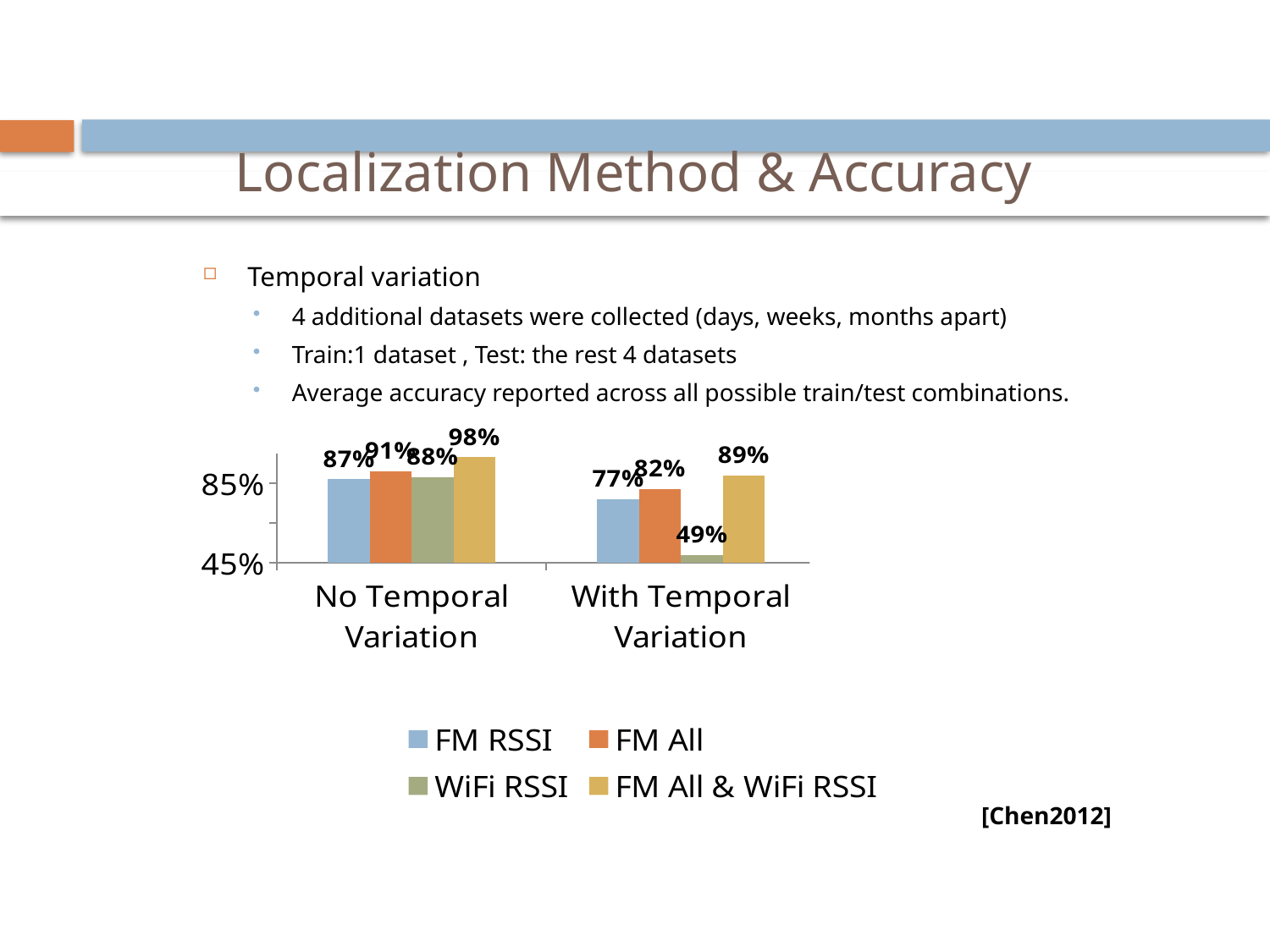
Is the WiFi RSSI value under With Temporal Variation greater or less than 85%? less Which series has the highest accuracy under No Temporal Variation? FM All & WiFi RSSI How many categories are shown on the x axis of the chart? 2 What is the accuracy for FM All & WiFi RSSI under No Temporal Variation? 98% What kind of chart is shown on the slide? bar chart What is the accuracy for FM RSSI under With Temporal Variation? 77% Which series has the lowest accuracy under With Temporal Variation? WiFi RSSI Which is larger: the FM All accuracy under No Temporal Variation or under With Temporal Variation? No Temporal Variation What is the difference between the WiFi RSSI accuracy under No Temporal Variation and under With Temporal Variation? 39% How many series does the chart legend list? 4 What is the accuracy for WiFi RSSI under With Temporal Variation? 49% Which legend entry is shown in orange? FM All